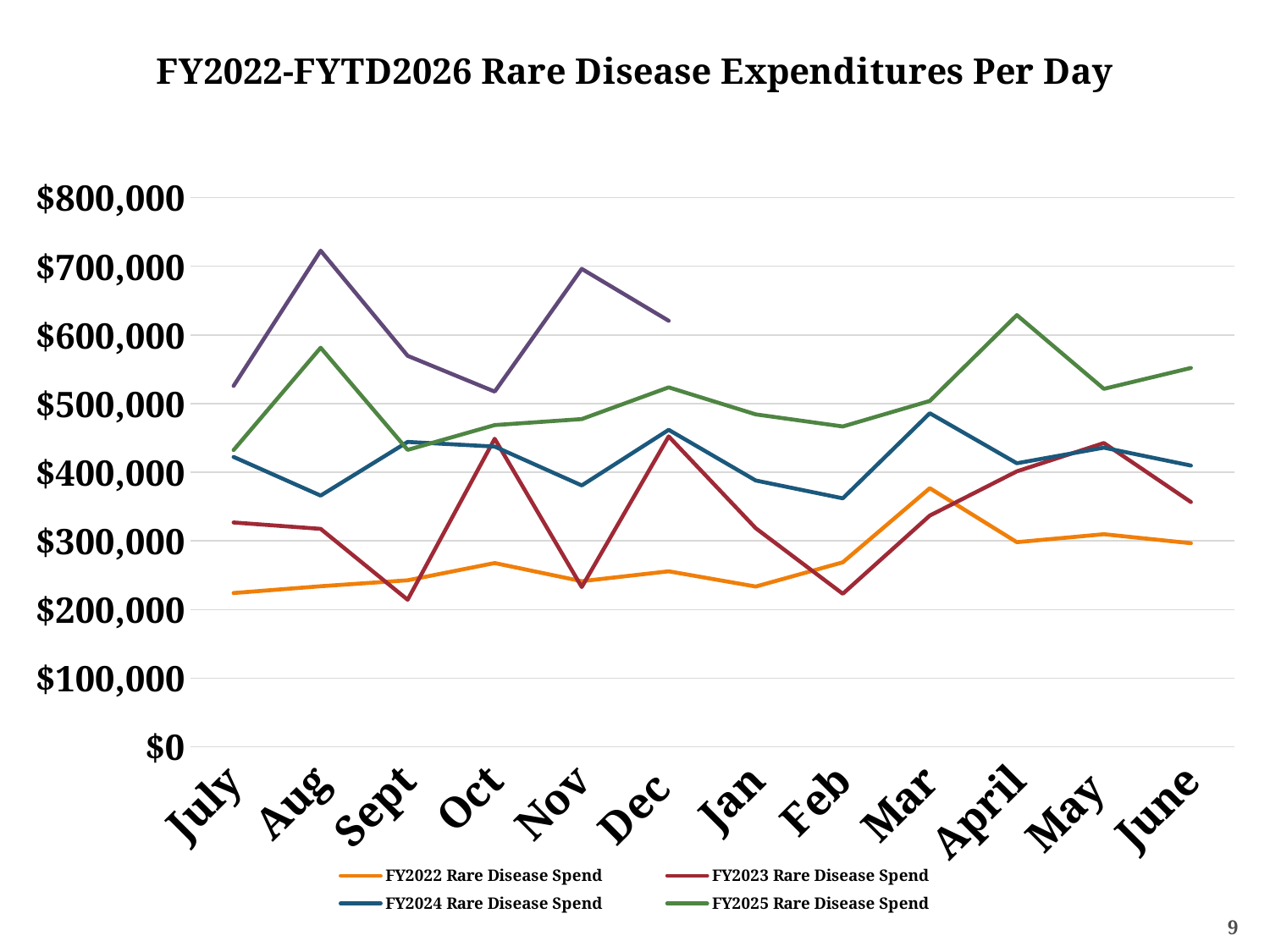
Does the FY2025 Rare Disease Spend rise or fall from April to May? fall How many series does the legend list? 4 Is the FY2023 Rare Disease Spend value for Sept greater or less than $300,000? less What kind of chart is shown on the slide? line chart Is the FY2022 Rare Disease Spend value for July greater or less than $300,000? less Is the FY2024 Rare Disease Spend value for Mar greater or less than $400,000? greater Which colour is used for the FY2025 Rare Disease Spend line? green In which month is the FY2025 Rare Disease Spend highest? April How many months are shown along the x axis? 12 What is the title of the chart? FY2022-FYTD2026 Rare Disease Expenditures Per Day In Oct, which is larger: the FY2023 Rare Disease Spend or the FY2022 Rare Disease Spend? FY2023 Rare Disease Spend